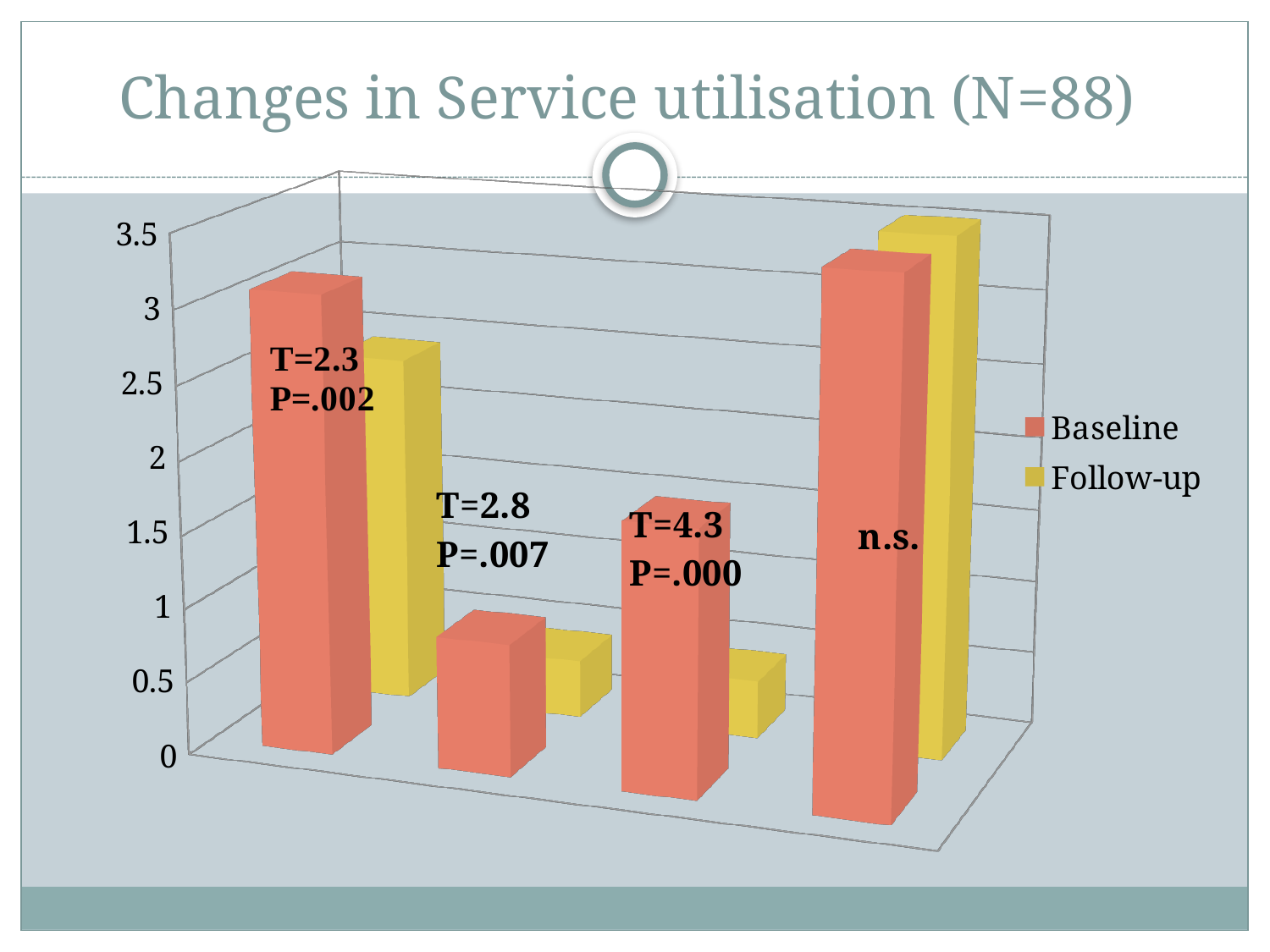
Is the Baseline value in the second group greater or less than 2? less How many groups of bars are plotted in the chart? 4 What is the title of the slide containing the chart? Changes in Service utilisation (N=88) Which group of bars has the tallest Baseline bar? the fourth (rightmost) group In the third group, which is larger, the Baseline bar or the Follow-up bar? Baseline Which group of bars has the shortest Baseline bar? the second group Is the Baseline value in the first (leftmost) group greater or less than 2? greater Which series is shown in red in the chart? Baseline Is the Follow-up value in the third group greater or less than 1? less In the first (leftmost) group, which is larger, the Baseline bar or the Follow-up bar? Baseline What kind of chart is shown on the slide? bar chart How many series does the legend list? 2